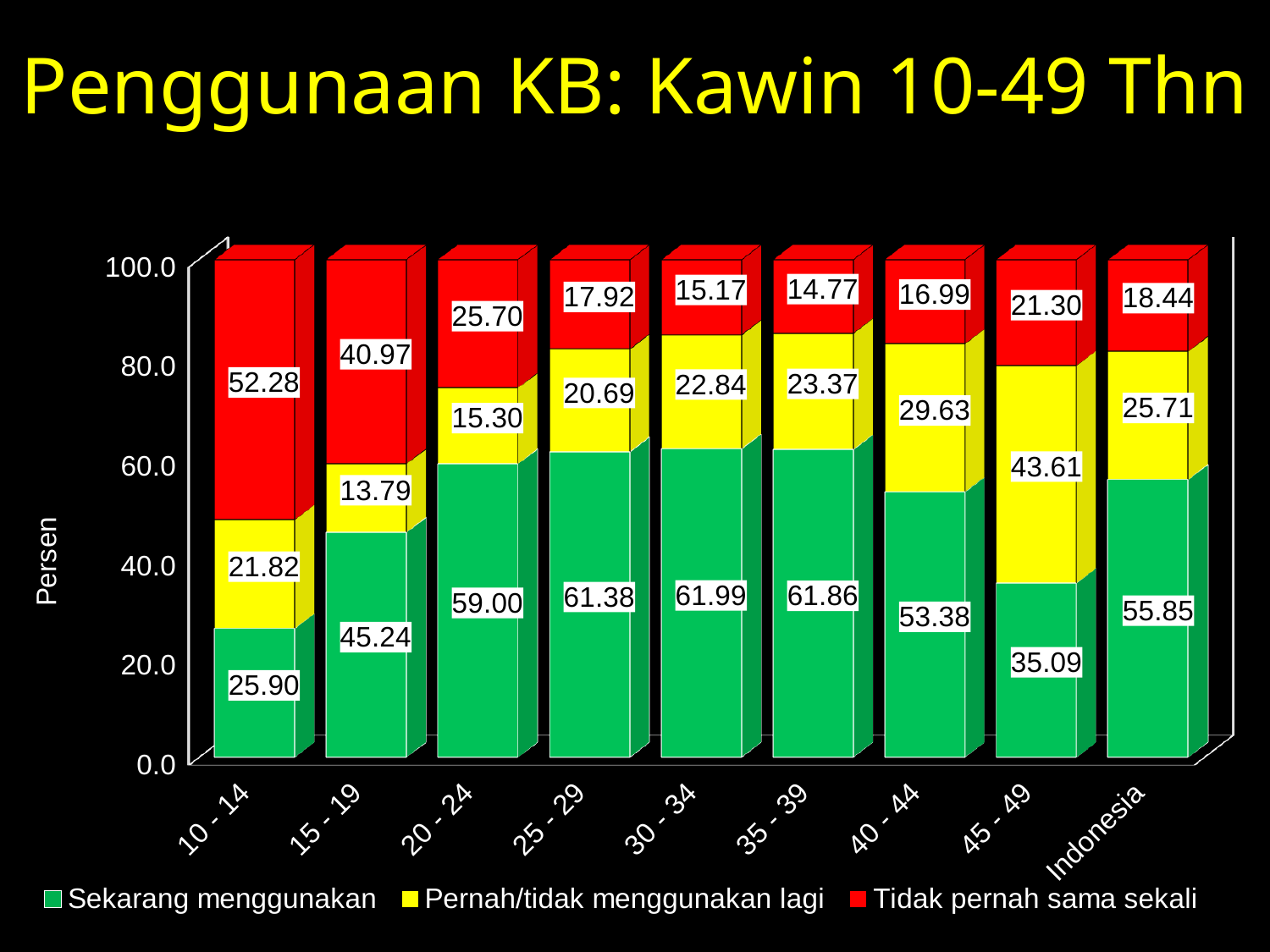
What is the value of "Pernah/tidak menggunakan lagi" for the 45 - 49 age group? 43.61 How many categories are shown on the x axis? 9 What is the value of "Tidak pernah sama sekali" for the 10 - 14 age group? 52.28 For Indonesia, what is the difference between "Sekarang menggunakan" and "Pernah/tidak menggunakan lagi"? 30.14 How many series does the legend list? 3 What is the value of "Sekarang menggunakan" for the 20 - 24 age group? 59.00 Which category has the highest value for "Sekarang menggunakan"? 30 - 34 What kind of chart is shown on the slide? Stacked bar chart What is the total of the stacked bar for the 10 - 14 age group? 100.00 What colour represents "Tidak pernah sama sekali" in the legend? Red Which category has the lowest value for "Tidak pernah sama sekali"? 35 - 39 Which has the larger "Sekarang menggunakan" value, 40 - 44 or 45 - 49? 40 - 44